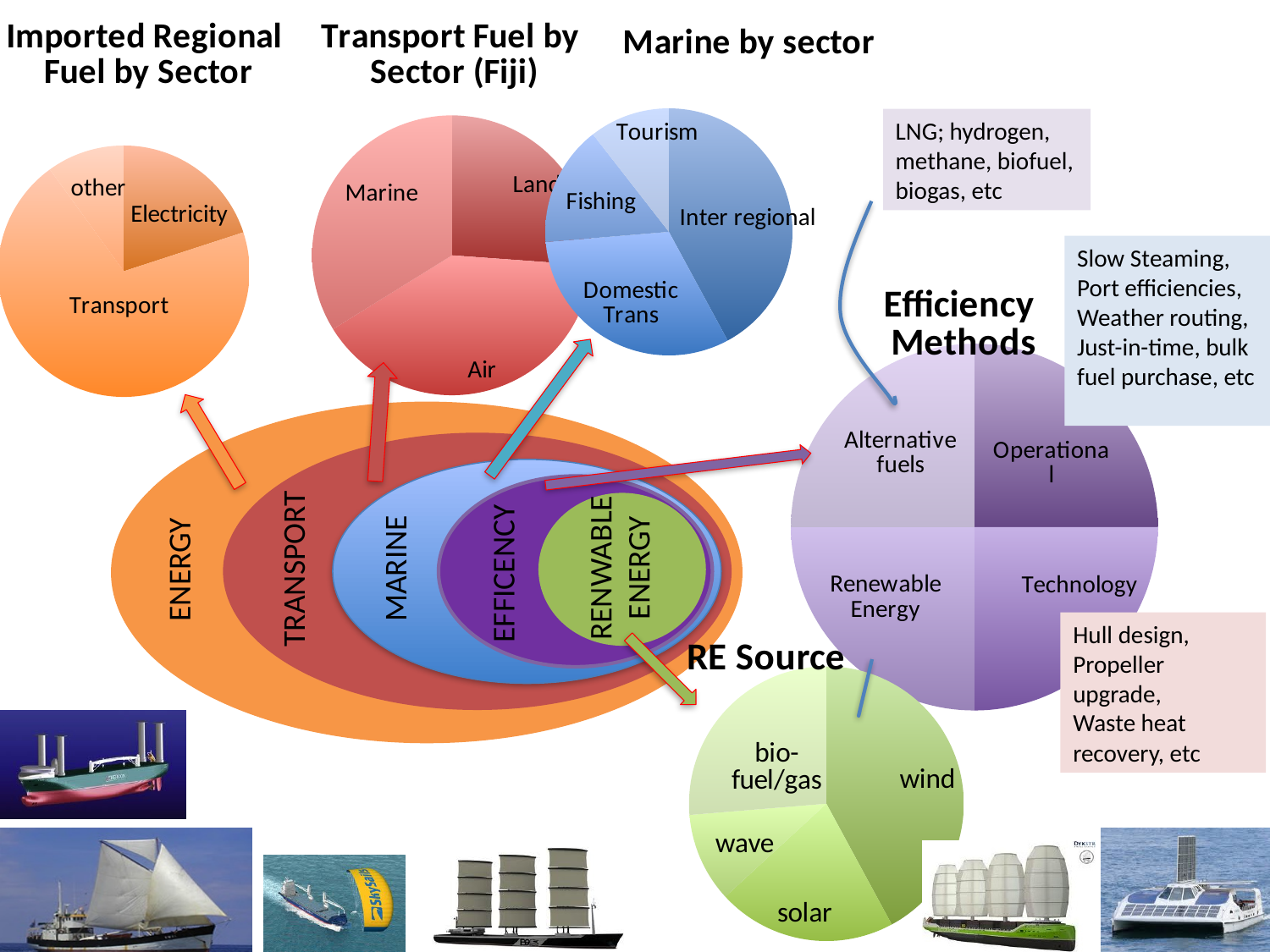
In the 'Transport Fuel by Sector (Fiji)' pie chart, which sector has the largest slice? Air What kind of chart is the 'Imported Regional Fuel by Sector' chart? Pie chart In the 'Imported Regional Fuel by Sector' pie chart, which sector has the largest slice? Transport How many slices does the 'Imported Regional Fuel by Sector' pie chart have? 3 How many slices does the 'Transport Fuel by Sector (Fiji)' pie chart have? 3 In the 'Marine by sector' pie chart, which slice is larger, Domestic Trans or Fishing? Domestic Trans In the 'RE Source' pie chart, which source has the smallest slice? wave In the 'Marine by sector' pie chart, which sector has the largest slice? Inter regional In the 'Imported Regional Fuel by Sector' pie chart, which slice is larger, Electricity or other? Electricity How many sectors are shown in the 'Marine by sector' pie chart? 4